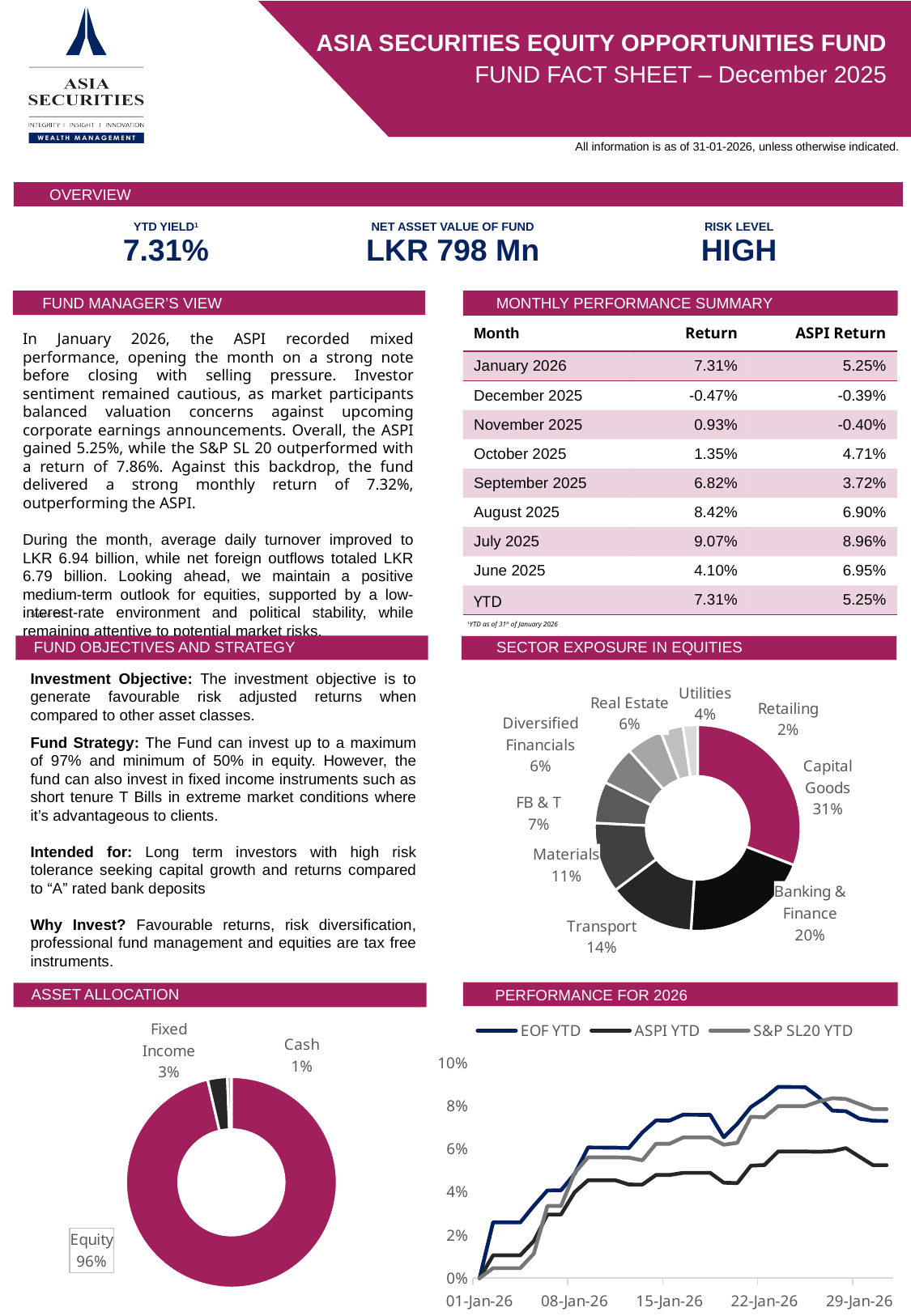
In the Performance for 2026 chart, do the EOF YTD values generally rise or fall from 01-Jan-26 to 29-Jan-26? rise In the Asset Allocation chart, what is the value for Fixed Income? 3% In the Sector Exposure in Equities chart, what share of equities is in Capital Goods? 31% How many sectors are shown in the Sector Exposure in Equities chart? 9 In the Sector Exposure in Equities chart, which sector has the smallest share? Retailing In the Sector Exposure in Equities chart, which is larger, Materials or FB & T? Materials In the Sector Exposure in Equities chart, which sector has the largest share? Capital Goods In the Performance for 2026 chart, is the EOF YTD value at the end of January greater or less than 6%? greater In the Asset Allocation chart, what share is allocated to Equity? 96% What kind of chart is the Asset Allocation chart? Pie (donut) chart How many series does the legend of the Performance for 2026 chart list? 3 In the Sector Exposure in Equities chart, what is the difference between the Banking & Finance share and the Transport share? 6%